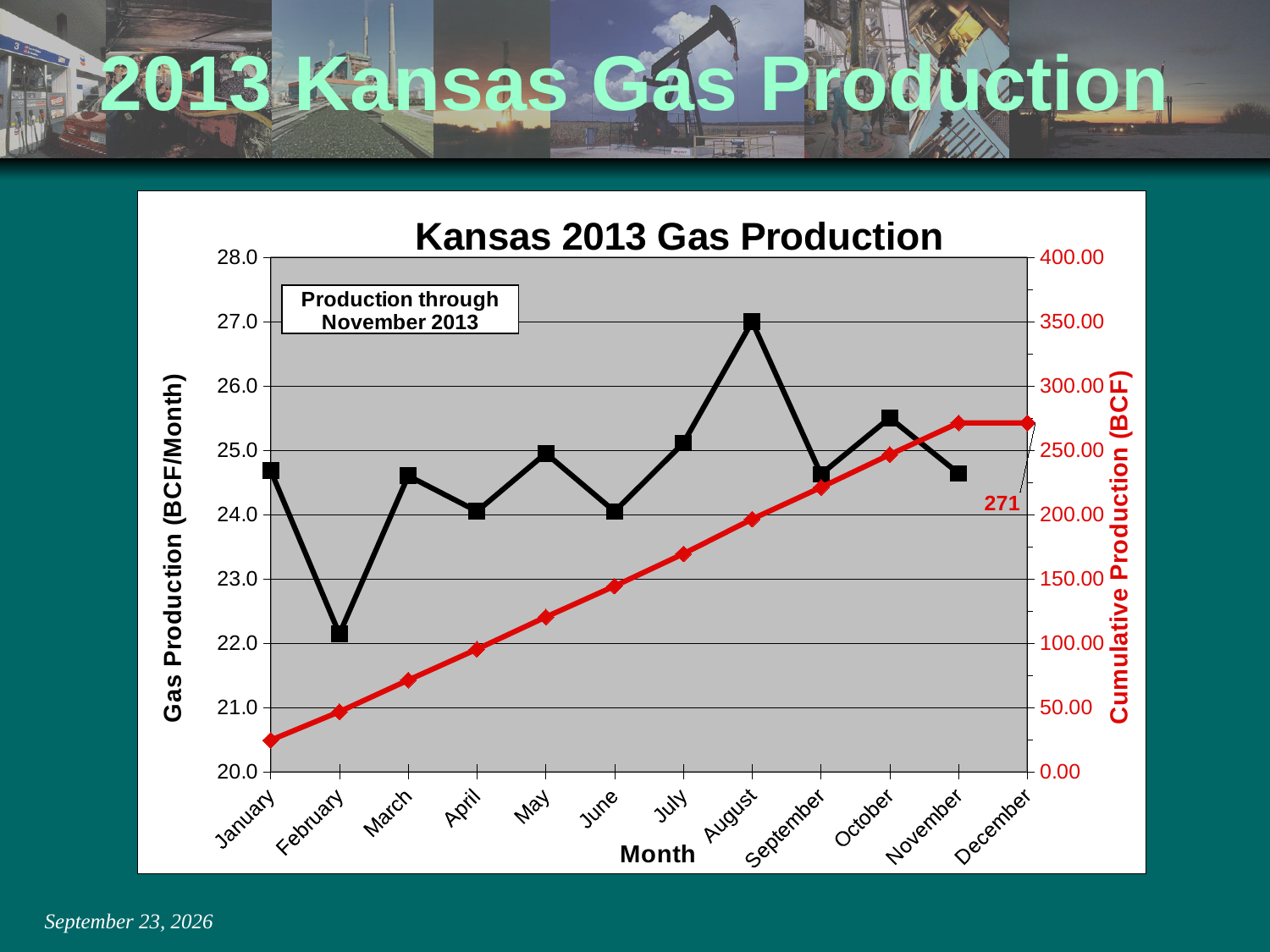
What cumulative production value is labelled at the end of the red line? 271 Is the cumulative production for July greater or less than 150.00? greater Which month has the highest monthly gas production on the black line? August Does the cumulative production (red line) rise or fall from January to November? rise How many months are shown on the x axis? 12 What kind of chart is shown on the slide? line chart What is the title of the chart? Kansas 2013 Gas Production Is the cumulative production for January greater or less than 50.00? less Which month has the lowest monthly gas production on the black line? February Is the monthly gas production for August greater or less than 26.0? greater Which month has the larger monthly gas production, January or February? January